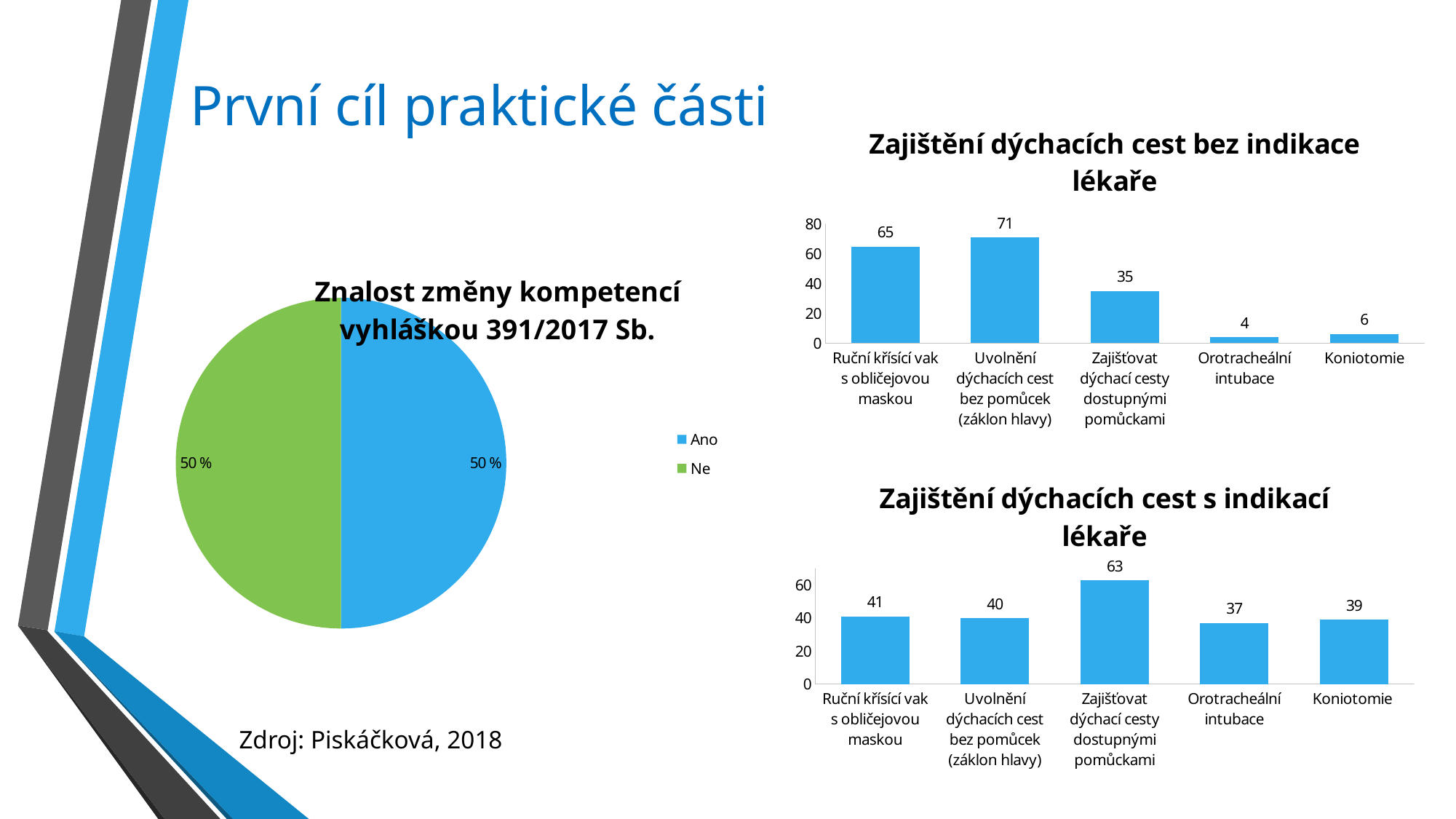
In the chart titled 'Zajištění dýchacích cest bez indikace lékaře', how many categories are shown? 5 In the chart titled 'Znalost změny kompetencí vyhláškou 391/2017 Sb.', what share does 'Ano' have? 50 % In the chart titled 'Znalost změny kompetencí vyhláškou 391/2017 Sb.', what colour is the 'Ne' slice? Green In the chart titled 'Zajištění dýchacích cest s indikací lékaře', what is the difference between 'Zajišťovat dýchací cesty dostupnými pomůckami' and 'Orotracheální intubace'? 26 In the chart titled 'Zajištění dýchacích cest bez indikace lékaře', what is the value for 'Uvolnění dýchacích cest bez pomůcek (záklon hlavy)'? 71 Which is larger: 'Koniotomie' in the chart 'Zajištění dýchacích cest bez indikace lékaře' or 'Koniotomie' in the chart 'Zajištění dýchacích cest s indikací lékaře'? Zajištění dýchacích cest s indikací lékaře In the chart titled 'Zajištění dýchacích cest bez indikace lékaře', which category has the lowest value? Orotracheální intubace In the chart titled 'Zajištění dýchacích cest s indikací lékaře', what is the value for 'Koniotomie'? 39 In the chart titled 'Zajištění dýchacích cest bez indikace lékaře', what is the difference between 'Ruční křísící vak s obličejovou maskou' and 'Zajišťovat dýchací cesty dostupnými pomůckami'? 30 In the chart titled 'Zajištění dýchacích cest s indikací lékaře', which category has the highest value? Zajišťovat dýchací cesty dostupnými pomůckami In the chart titled 'Zajištění dýchacích cest s indikací lékaře', what kind of chart is it? Bar chart In the chart titled 'Znalost změny kompetencí vyhláškou 391/2017 Sb.', how many entries does the legend list? 2